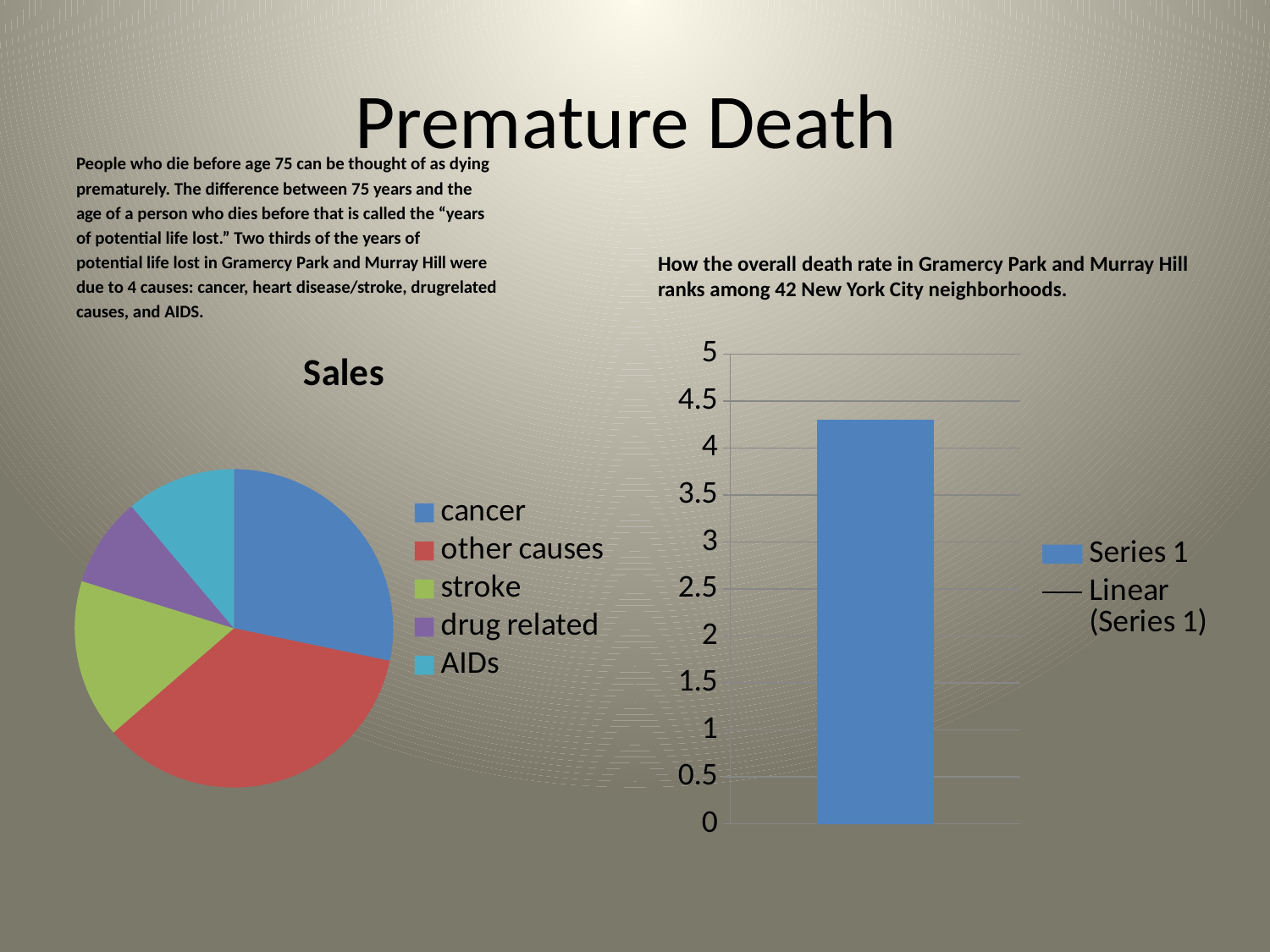
What kind of chart is the chart titled "Sales" on the left of the slide? pie chart What kind of chart is the chart on the right of the slide? bar chart In the bar chart on the right of the slide, is the value of the bar greater or less than 4? greater In the pie chart titled "Sales", which slice is larger, stroke or drug related? stroke In the bar chart on the right of the slide, how many entries does the legend list? 2 In the bar chart on the right of the slide, is the value of the bar greater or less than 4.5? less In the pie chart titled "Sales", which slice is larger, cancer or stroke? cancer In the pie chart titled "Sales", how many slices (categories) are there? 5 In the pie chart titled "Sales", which category has the largest slice? other causes In the bar chart on the right of the slide, how many bars are plotted? 1 In the pie chart titled "Sales", which slice is larger, other causes or cancer? other causes What is the title of the pie chart on the left of the slide? Sales